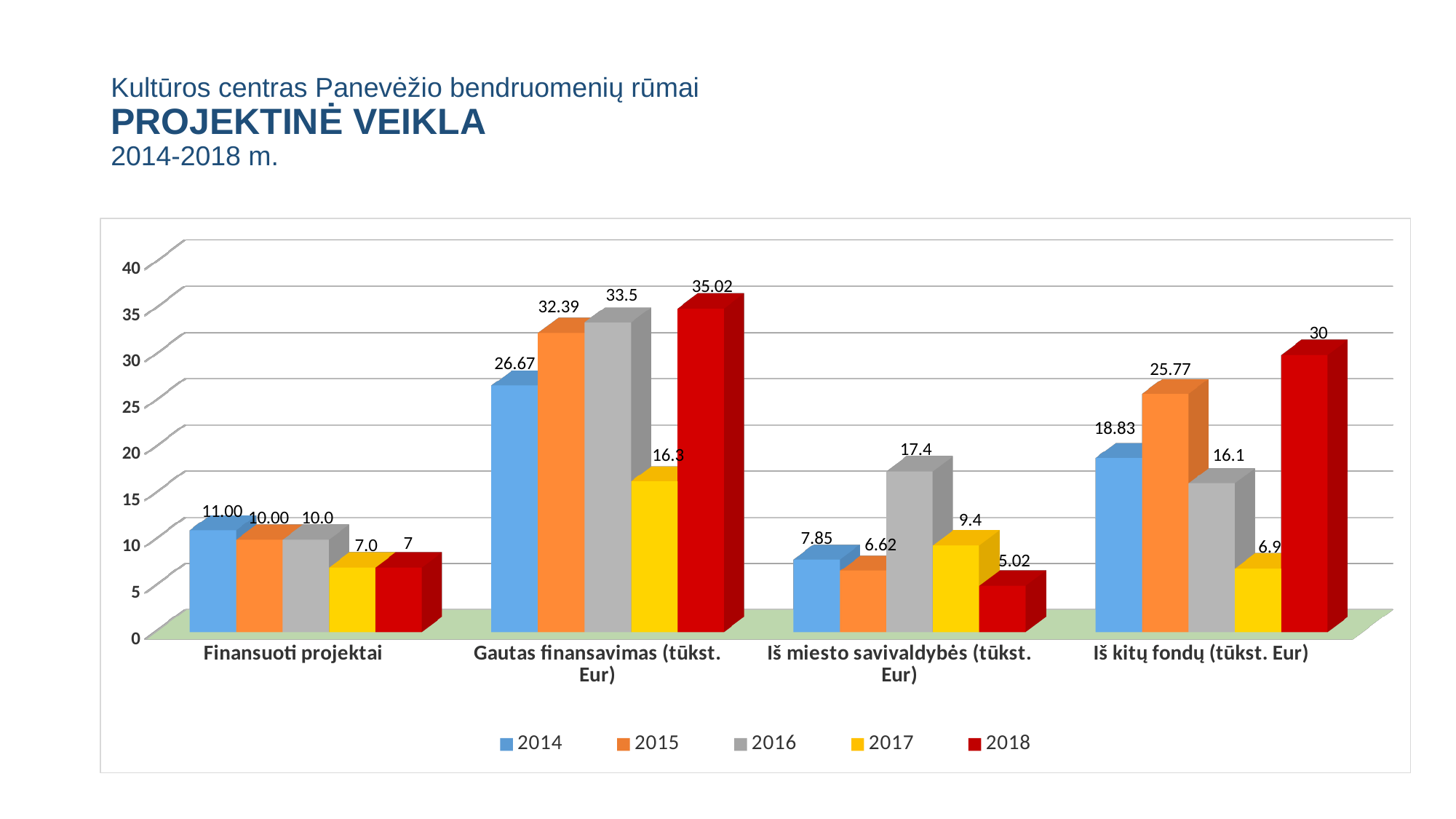
What is the value for 2017 in the "Finansuoti projektai" category? 7.0 What is the difference between the 2015 and 2014 values in the "Gautas finansavimas (tūkst. Eur)" category? 5.72 Is the 2016 value in the "Gautas finansavimas (tūkst. Eur)" category greater or less than 30? greater What is the value for 2016 in the "Iš miesto savivaldybės (tūkst. Eur)" category? 17.4 How many series does the legend list? 5 What is the value for 2018 in the "Gautas finansavimas (tūkst. Eur)" category? 35.02 Which year has the lowest value in the "Iš miesto savivaldybės (tūkst. Eur)" category? 2018 What kind of chart is shown on the slide? Bar chart In the "Iš kitų fondų (tūkst. Eur)" category, which is larger: the 2015 value or the 2016 value? 2015 Which year has the highest value in the "Iš kitų fondų (tūkst. Eur)" category? 2018 What is the value for 2014 in the "Iš kitų fondų (tūkst. Eur)" category? 18.83 How many categories are shown on the x axis of the chart? 4